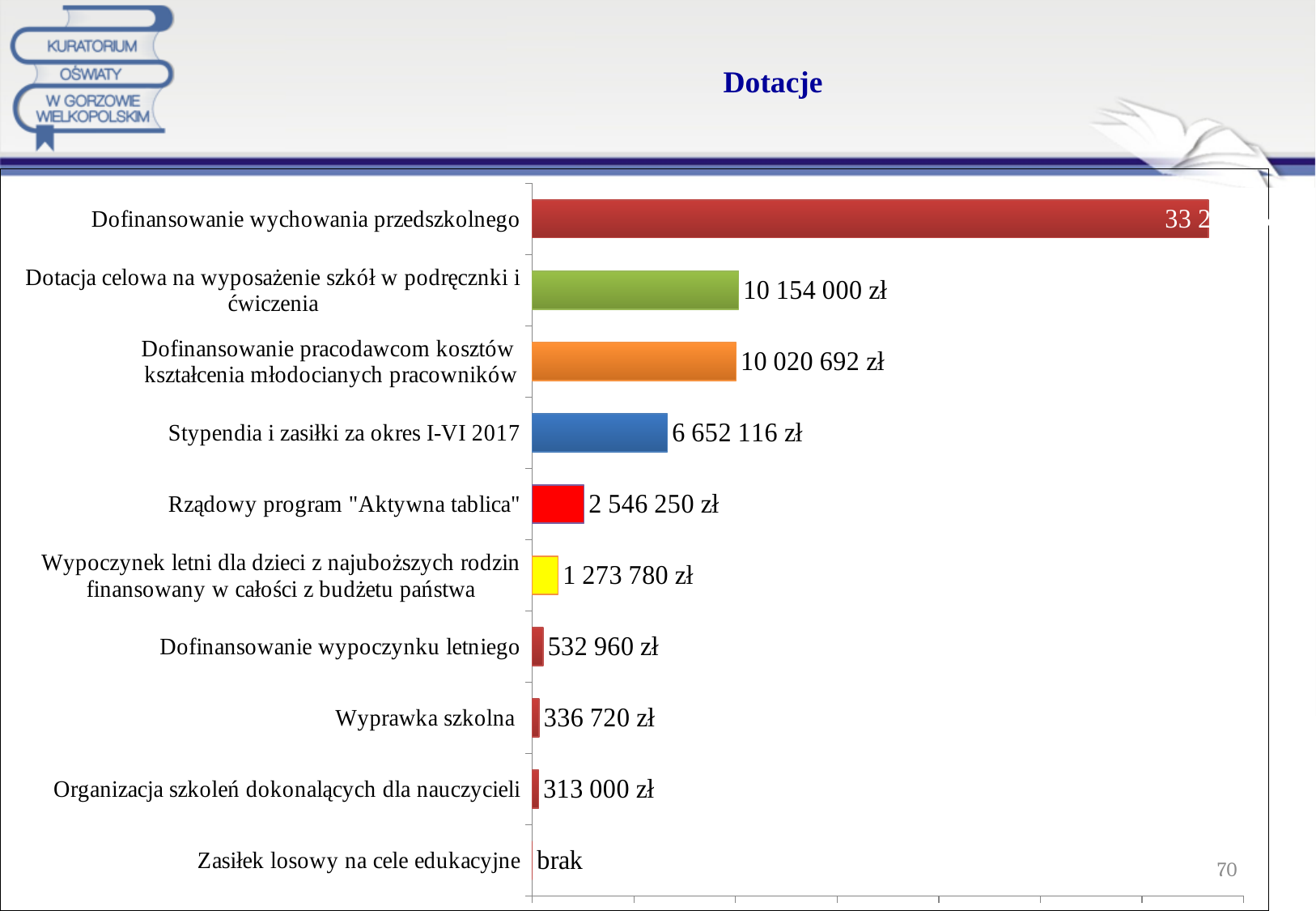
What is the value for "Rządowy program "Aktywna tablica""? 2 546 250 zł What is the difference between "Dotacja celowa na wyposażenie szkół w podręczniki i ćwiczenia" and "Dofinansowanie pracodawcom kosztów kształcenia młodocianych pracowników"? 133 308 zł What is the value for "Dofinansowanie pracodawcom kosztów kształcenia młodocianych pracowników"? 10 020 692 zł What kind of chart is shown on the slide? Bar chart Which category has the highest value? Dofinansowanie wychowania przedszkolnego What is the value for "Stypendia i zasiłki za okres I-VI 2017"? 6 652 116 zł What is the value for "Wyprawka szkolna"? 336 720 zł How many categories are listed on the chart? 10 Which category with a bar has the lowest value? Organizacja szkoleń dokonalących dla nauczycieli What is the value for "Dotacja celowa na wyposażenie szkół w podręczniki i ćwiczenia"? 10 154 000 zł What is the difference between "Dofinansowanie wypoczynku letniego" and "Wyprawka szkolna"? 196 240 zł Which is larger: "Stypendia i zasiłki za okres I-VI 2017" or "Rządowy program "Aktywna tablica""? Stypendia i zasiłki za okres I-VI 2017